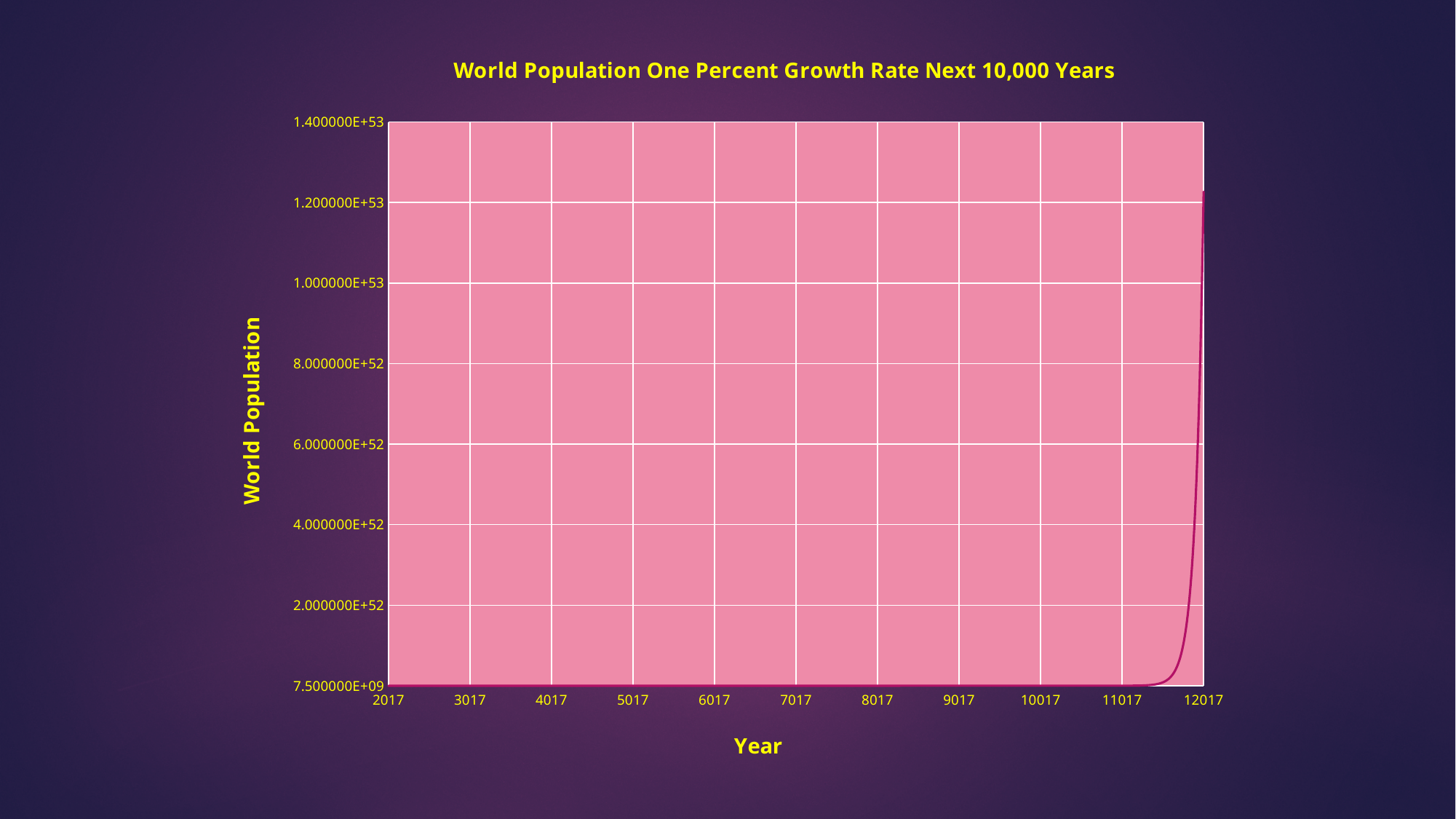
In which year does the plotted world population reach its highest value? 12017 What is the last year label on the x axis? 12017 Do the plotted values rise or fall as the year increases along the x axis? rise Is the value for the year 12017 greater or less than 1.000000E+53? greater What is the label of the vertical axis? World Population Is the value for the year 11017 greater or less than 2.000000E+52? less How many year labels are shown along the x axis? 11 What kind of chart is shown on the slide? line chart Which year has the larger plotted value, 11017 or 12017? 12017 Is the value for the year 7017 greater or less than 2.000000E+52? less What is the title of the chart? World Population One Percent Growth Rate Next 10,000 Years What is the first year label on the x axis? 2017